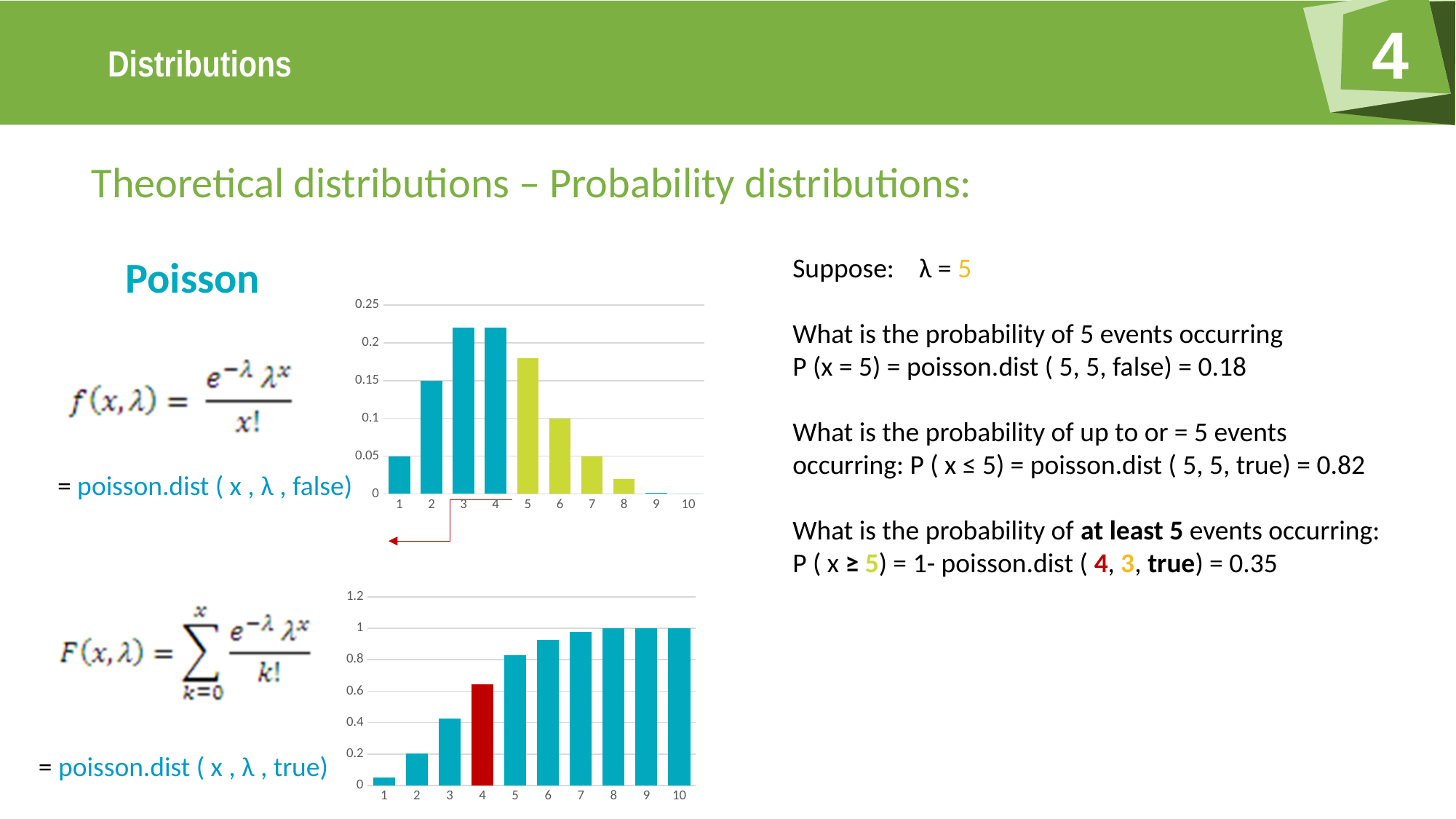
In the top chart, is the value for category 8 greater or less than 0.05? less In the bottom chart, which category's bar is coloured red? 4 In the bottom chart, which category has the lowest value? 1 In the top chart, what is the value for category 6? 0.1 In the bottom chart, is the value for category 6 greater or less than 0.8? greater In the top chart, which is larger, the value for category 2 or the value for category 6? category 2 What kind of chart is the top chart on the slide? bar chart In the top chart, is the value for category 5 greater or less than 0.15? greater In the bottom chart, do the values rise or fall as the x axis goes from 1 to 10? rise How many categories are shown on the x axis of the bottom chart? 10